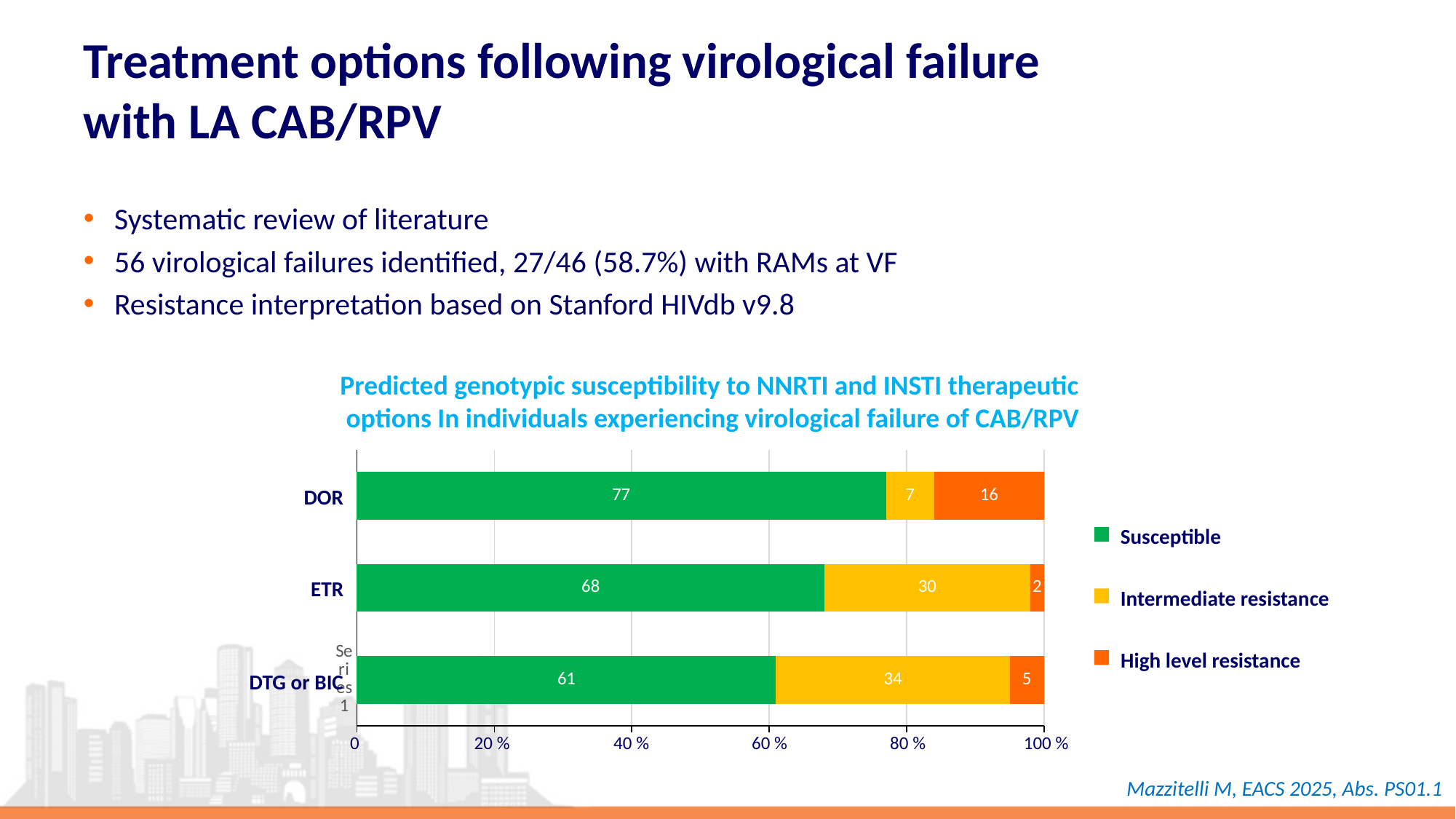
Which is larger, the Intermediate resistance value for ETR or for DTG or BIC? DTG or BIC What is the High level resistance value for DOR? 16 What is the High level resistance value for DTG or BIC? 5 What is the total of the stacked bar for ETR? 100 Which category has the lowest High level resistance value? ETR What is the Susceptible value for DOR? 77 How many categories are shown on the chart? 3 What is the difference between the Susceptible values for DOR and DTG or BIC? 16 Which category has the highest Susceptible value? DOR What kind of chart is shown on the slide? Stacked bar chart How many series does the legend list? 3 What is the Intermediate resistance value for ETR? 30